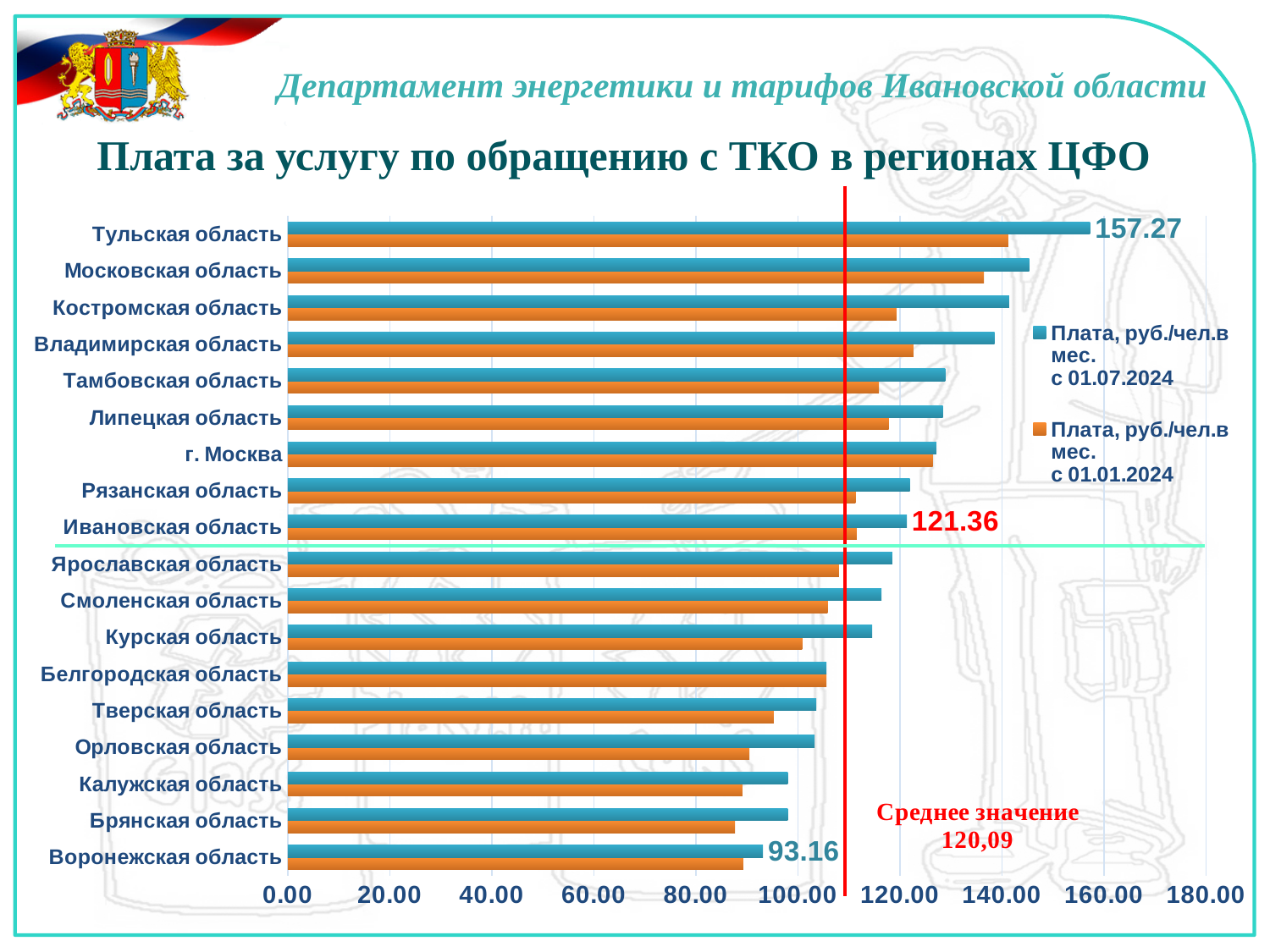
Is the 01.07.2024 value for Московская область greater or less than 140.00? greater How many regions are shown on the chart? 18 What average value (Среднее значение) is noted on the chart? 120,09 How many series does the legend list? 2 What is the difference between the 01.07.2024 values for Тульская область and Ивановская область? 35.91 What is the difference between the 01.07.2024 values for Тульская область and Воронежская область? 64.11 What is the value for Воронежская область in the series 'Плата, руб./чел.в мес. с 01.07.2024'? 93.16 What kind of chart is shown on the slide? Bar chart What is the value for Тульская область in the series 'Плата, руб./чел.в мес. с 01.07.2024'? 157.27 What is the value for Ивановская область in the series 'Плата, руб./чел.в мес. с 01.07.2024'? 121.36 Which region has the highest value in the series 'Плата, руб./чел.в мес. с 01.07.2024'? Тульская область Which region has the lowest value in the series 'Плата, руб./чел.в мес. с 01.07.2024'? Воронежская область